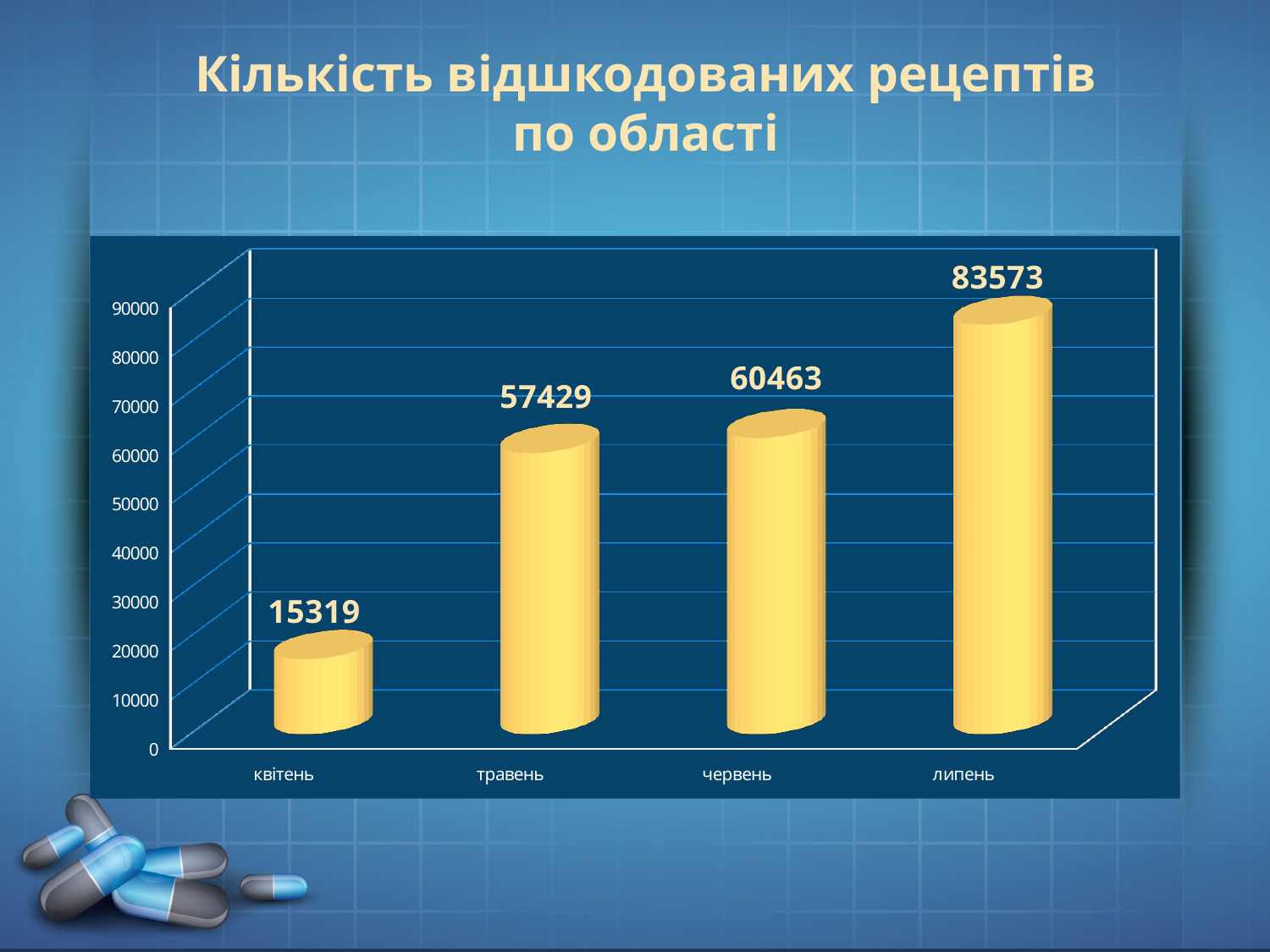
What kind of chart is shown on the slide? bar chart What is the value for квітень? 15319 How many months are shown on the chart? 4 Which is larger, the value for травень or the value for липень? липень What is the value for червень? 60463 Which month has the lowest value? квітень Which month has the highest value? липень What is the difference between the values for червень and травень? 3034 What is the value for липень? 83573 Do the values rise or fall from квітень to липень? rise What is the difference between the values for липень and квітень? 68254 What is the value for травень? 57429